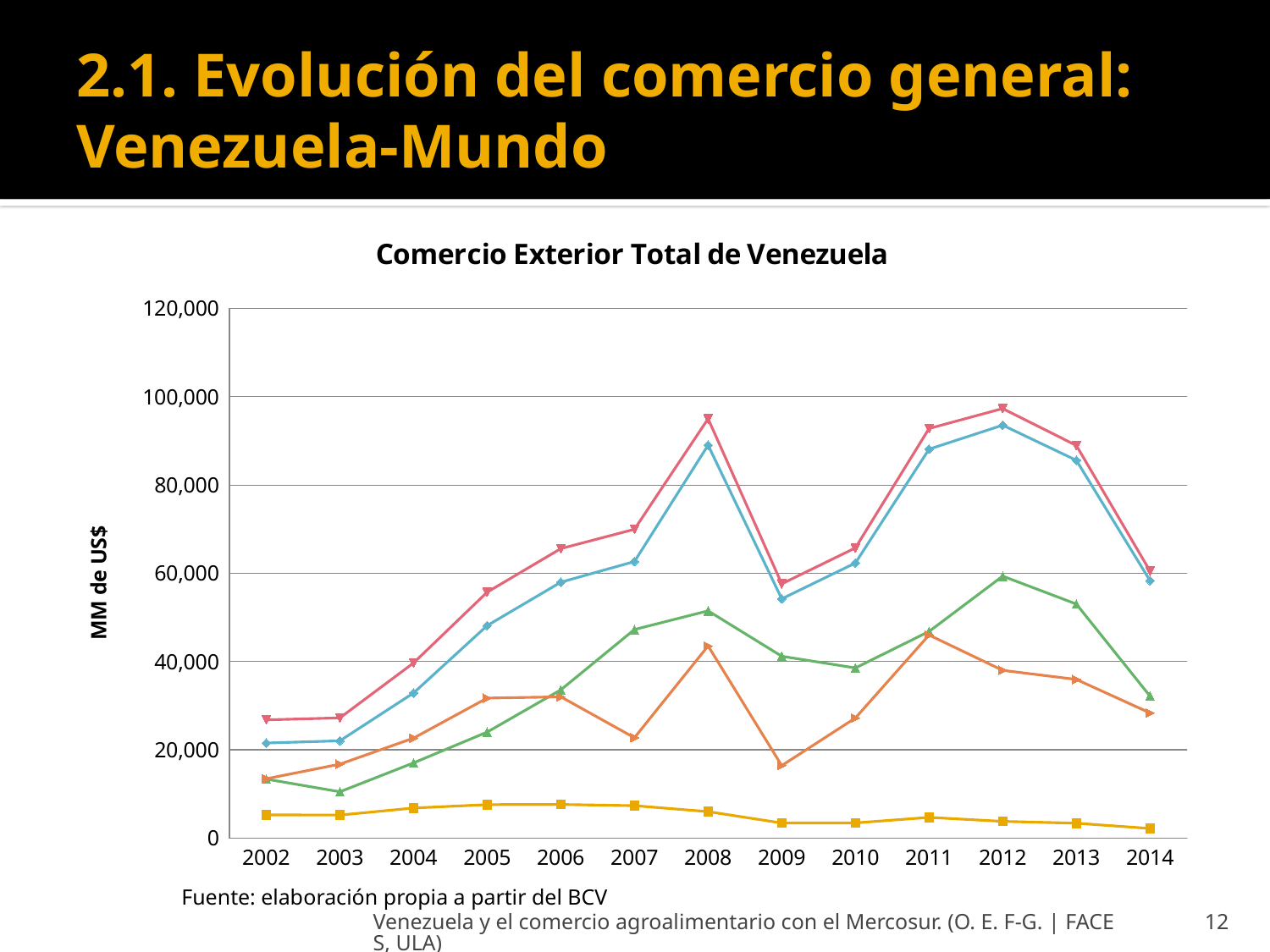
Is the value of the orange line in 2009 greater or less than 20,000? less What kind of chart is shown on the slide? line chart For the pink line, which year has the larger value, 2008 or 2009? 2008 What is the label on the vertical axis of the chart? MM de US$ In which year does the green line reach its lowest value? 2003 What is the title of the chart? Comercio Exterior Total de Venezuela In 2012, which line has the larger value, the green line or the orange line? the green line In which year does the pink line reach its highest value? 2012 How many years are shown along the x axis of the chart? 13 Does the pink line rise or fall from 2012 to 2014? fall Is the value of the yellow line in 2005 greater or less than 20,000? less Is the value of the pink line in 2008 greater or less than 80,000? greater